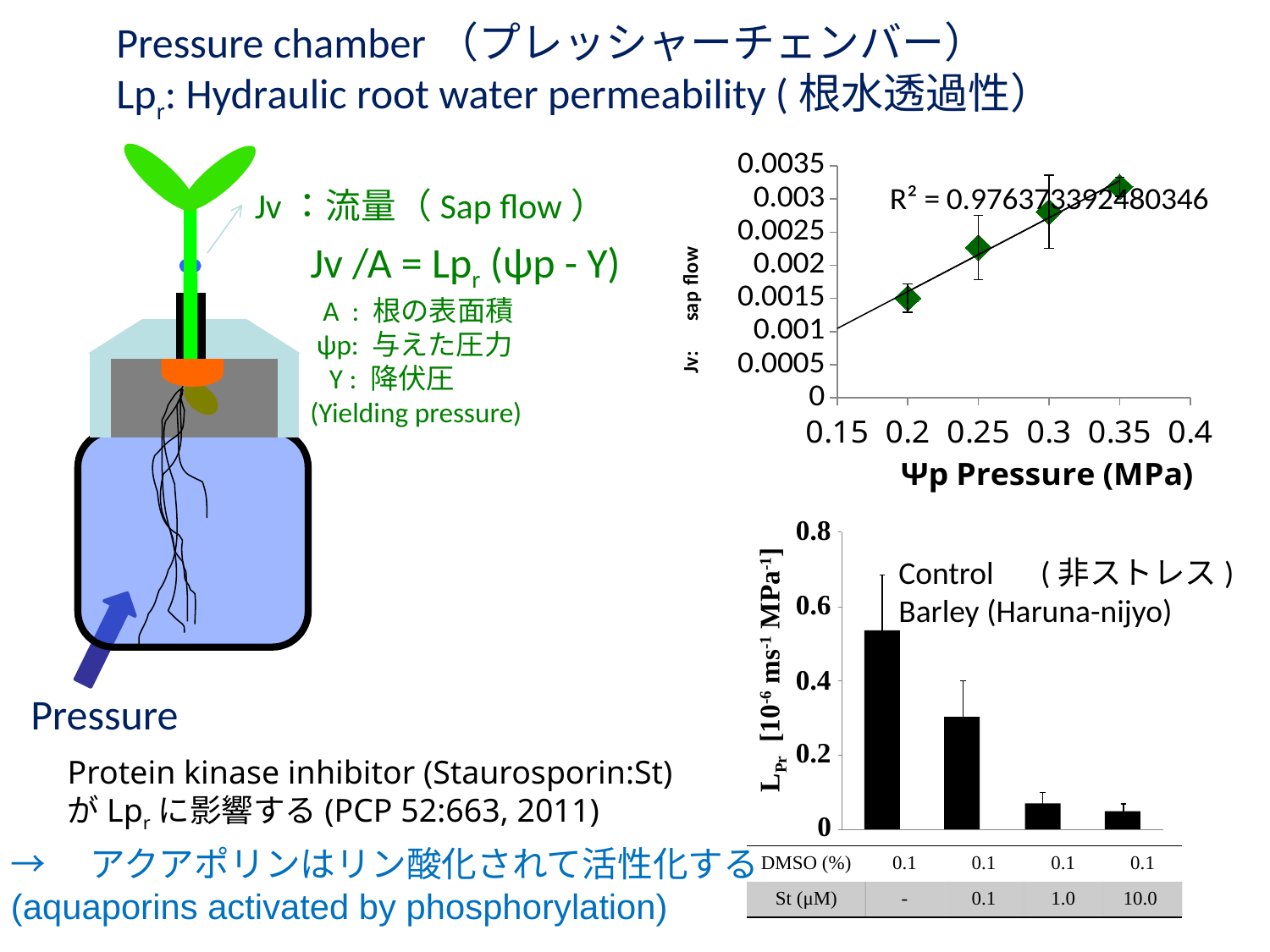
What type of chart is the bottom-right chart showing LPr? bar chart In the top-right sap flow chart, how many data points are plotted? 4 In the top-right sap flow chart, does sap flow rise or fall as Ψp pressure increases? rise What type of chart is the top-right chart plotting sap flow against Ψp pressure? scatter plot In the top-right sap flow chart, is the sap flow value at 0.35 MPa greater or less than 0.003? greater In the top-right sap flow chart, is the sap flow value at 0.2 MPa greater or less than 0.002? less In the bottom-right LPr bar chart, does LPr rise or fall as the St concentration increases? fall In the top-right sap flow chart, what is the x-axis label? Ψp Pressure (MPa) In the bottom-right LPr bar chart, which St (μM) condition has the highest LPr? - (no St) In the bottom-right LPr bar chart, how many bars are shown? 4 In the top-right sap flow chart, what R² value is printed on the chart? R² = 0.976373392480346 In the bottom-right LPr bar chart, is the LPr value for St 0.1 μM greater or less than 0.4? less